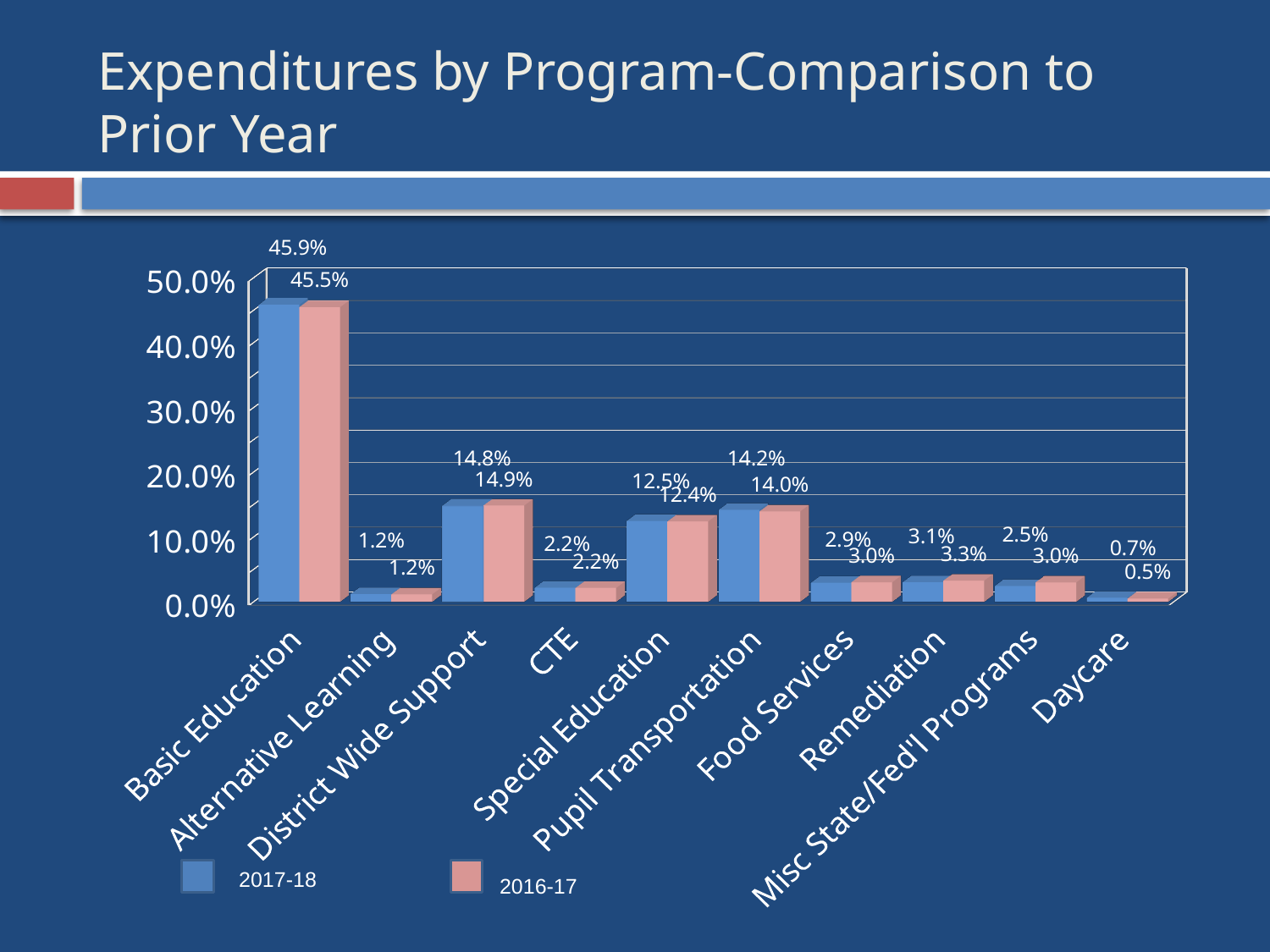
What is the 2016-17 value for Misc State/Fed'l Programs? 3.0% What is the difference between the 2017-18 and 2016-17 values for Basic Education? 0.4% What kind of chart is shown on the slide? Bar chart Which program has the lowest 2016-17 expenditure share? Daycare What is the 2017-18 value for Special Education? 12.5% What is the 2017-18 value for Basic Education? 45.9% Which is larger for Remediation, the 2017-18 value or the 2016-17 value? 2016-17 How many series does the legend list? 2 What is the 2016-17 value for Pupil Transportation? 14.0% Which program has the highest 2017-18 expenditure share? Basic Education How many programs (categories) are shown on the x axis? 10 What is the difference between the 2016-17 and 2017-18 values for Misc State/Fed'l Programs? 0.5%